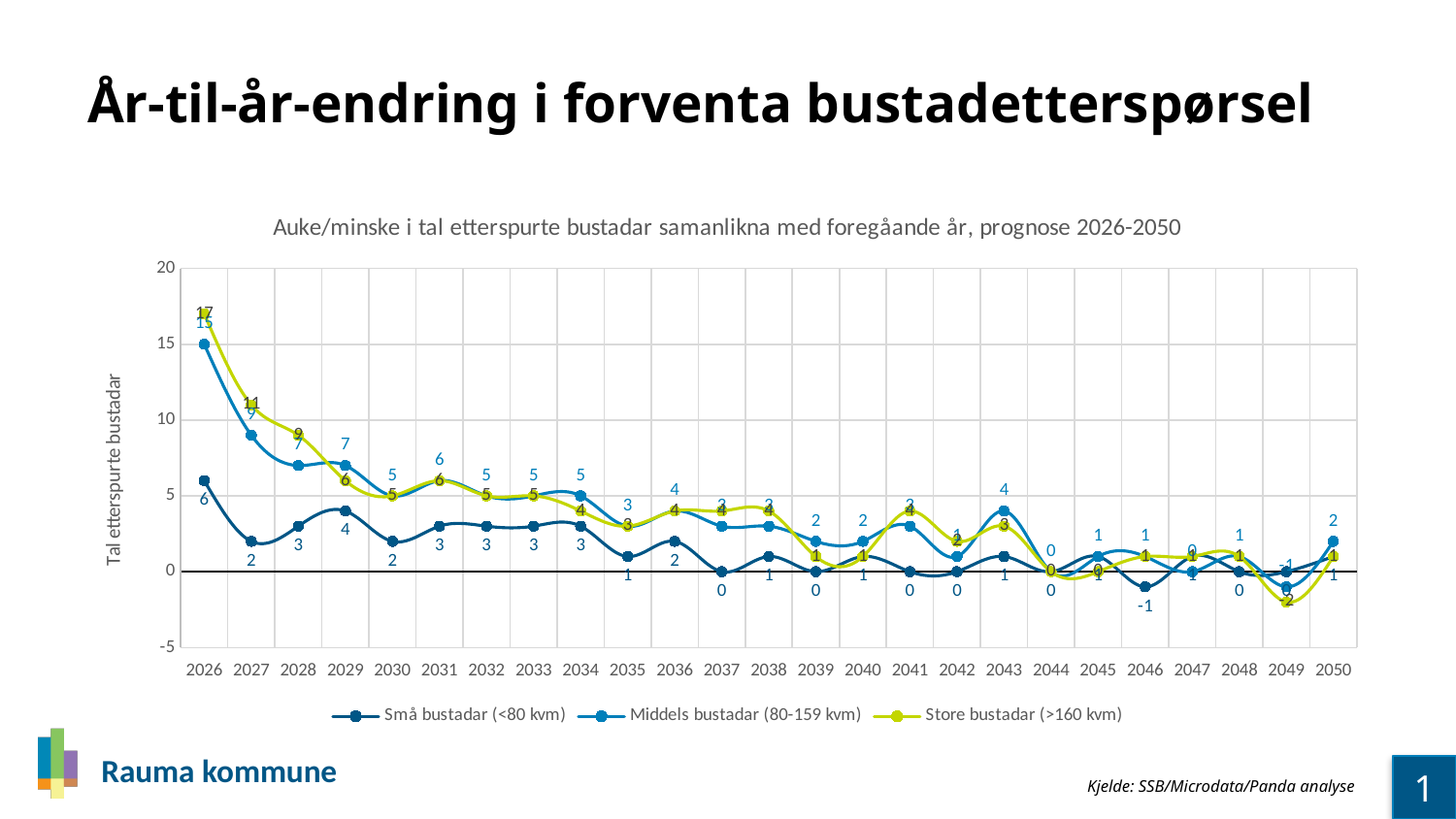
What is the value for Store bustadar (>160 kvm) in 2026? 17 Which series has the larger value in 2026, Store bustadar (>160 kvm) or Små bustadar (<80 kvm)? Store bustadar (>160 kvm) In which year does Store bustadar (>160 kvm) reach its highest value? 2026 What is the value for Små bustadar (<80 kvm) in 2026? 6 What is the value for Store bustadar (>160 kvm) in 2049? -2 What is the value for Middels bustadar (80-159 kvm) in 2026? 15 What is the value for Små bustadar (<80 kvm) in 2046? -1 How many series does the legend list? 3 What is the difference between Store bustadar (>160 kvm) and Middels bustadar (80-159 kvm) in 2026? 2 How many years are plotted along the x axis? 25 Do the values for Middels bustadar (80-159 kvm) generally rise or fall from 2026 to 2050? fall What type of chart is shown on the slide? line chart